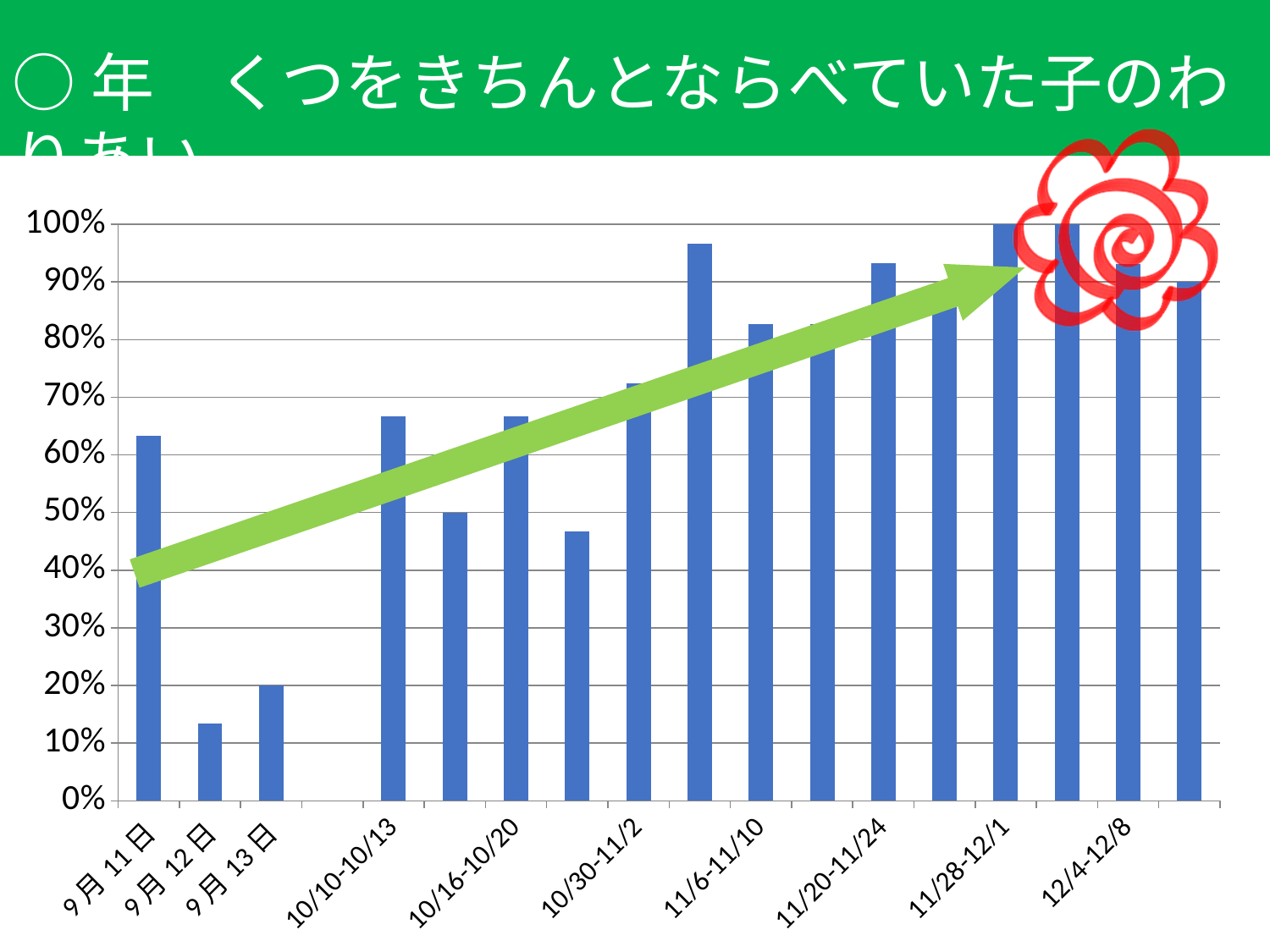
What kind of chart is shown on the slide? bar chart What is the value for 9月13日? 20% Is the value for 10/16-10/20 greater or less than 60%? greater Is the value for 10/30-11/2 greater or less than 70%? greater Do the values generally rise or fall from left to right along the x axis? rise Which labeled category has the lowest value? 9月12日 What is the value for 11/28-12/1? 100% Which is larger, the value for 9月11日 or the value for 9月12日? 9月11日 What colour are the bars in the chart? blue Is the value for 9月12日 greater or less than 20%? less